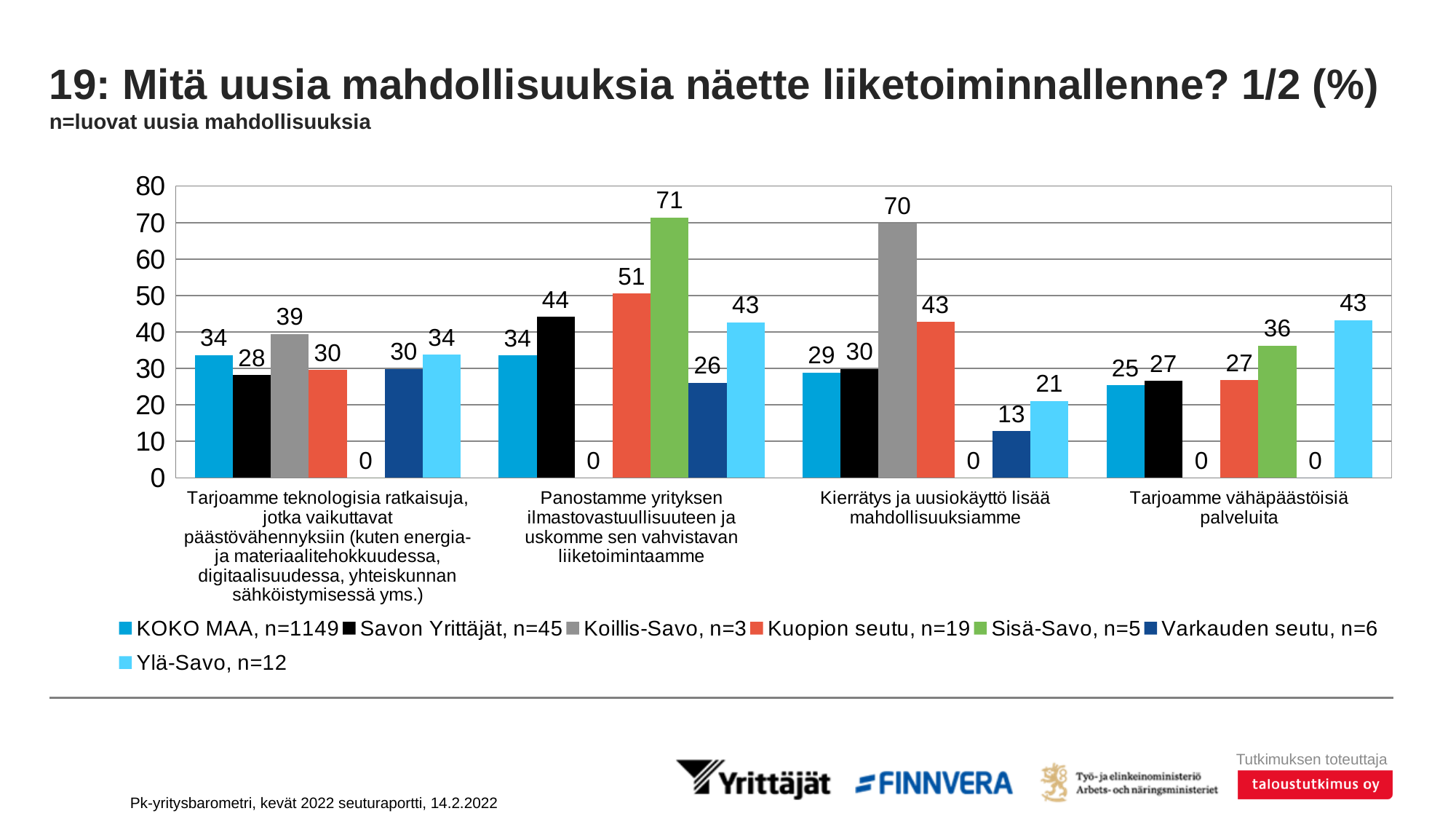
What is the value for Koillis-Savo, n=3 in the category 'Kierrätys ja uusiokäyttö lisää mahdollisuuksiamme'? 70 Which series has the highest value in the category 'Tarjoamme teknologisia ratkaisuja, jotka vaikuttavat päästövähennyksiin'? Koillis-Savo, n=3 What is the value for Savon Yrittäjät, n=45 in the category 'Panostamme yrityksen ilmastovastuullisuuteen ja uskomme sen vahvistavan liiketoimintaamme'? 44 What kind of chart is shown on the slide? bar chart How does the value for KOKO MAA, n=1149 change across the four categories from left to right? It stays at 34 for the first two, then falls to 29 and 25 In the category 'Tarjoamme vähäpäästöisiä palveluita', which is larger: Ylä-Savo, n=12 or Sisä-Savo, n=5? Ylä-Savo, n=12 What is the value for KOKO MAA, n=1149 in the category 'Tarjoamme vähäpäästöisiä palveluita'? 25 Which series has the lowest non-zero value in the category 'Kierrätys ja uusiokäyttö lisää mahdollisuuksiamme'? Varkauden seutu, n=6 How many categories are shown on the x axis? 4 How many series does the legend list? 7 What is the value for Sisä-Savo, n=5 in the category 'Panostamme yrityksen ilmastovastuullisuuteen ja uskomme sen vahvistavan liiketoimintaamme'? 71 What is the difference between Sisä-Savo, n=5 and Kuopion seutu, n=19 in the category 'Panostamme yrityksen ilmastovastuullisuuteen ja uskomme sen vahvistavan liiketoimintaamme'? 20